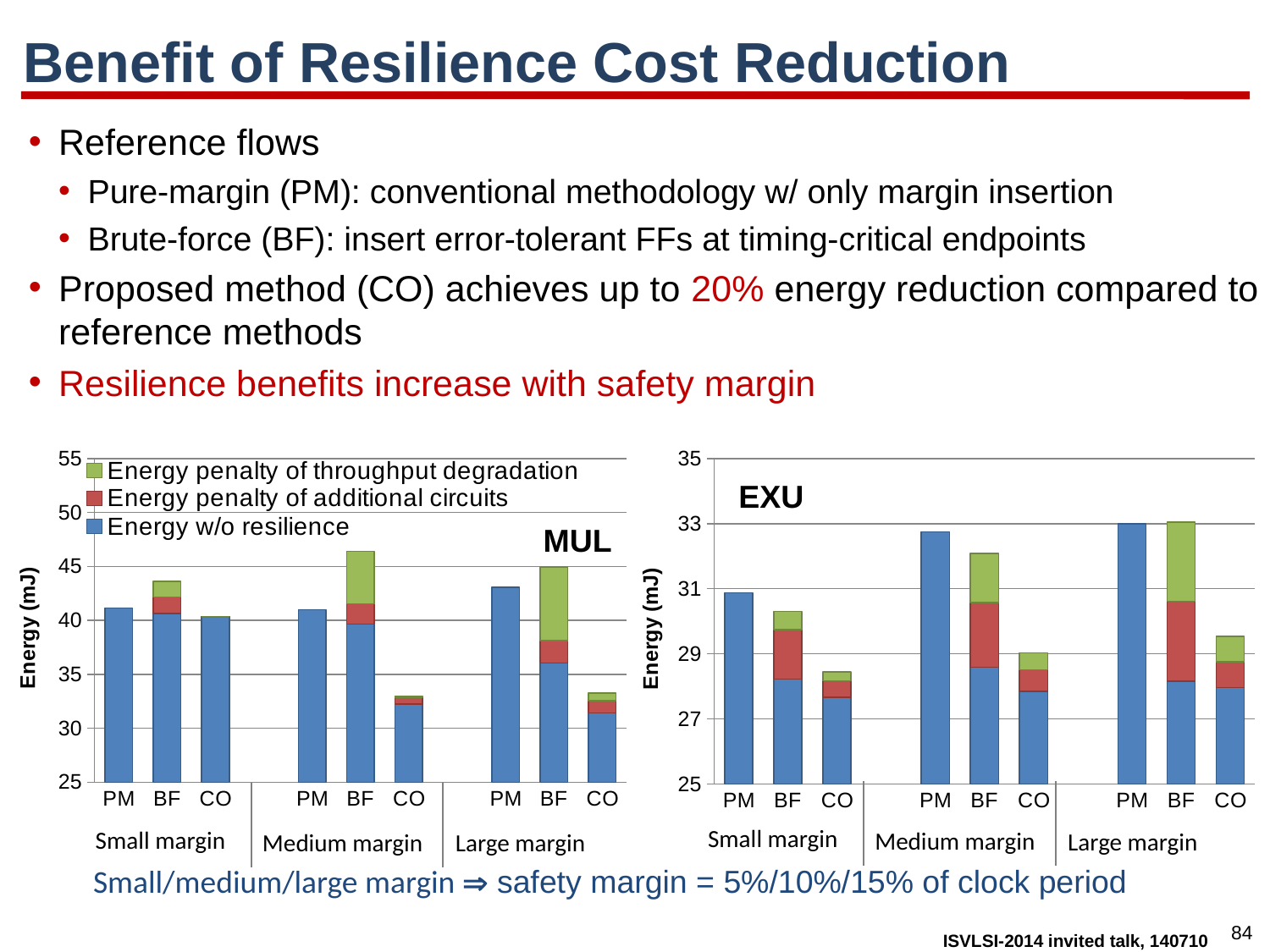
In the EXU chart, do the PM values rise or fall from Small margin to Large margin? rise How many series does the legend on the MUL chart list? 3 What kind of chart is the MUL chart? bar chart In the MUL chart, is the total for CO under Medium margin greater or less than 35? less In the EXU chart, is the value for PM under Medium margin greater or less than 31? greater In the MUL chart, which has the taller total bar under Medium margin, PM or BF? BF How many bars are plotted in the MUL chart? 9 In the MUL chart, which bar has the highest total energy? BF under Medium margin In the MUL chart, is the value for PM under Small margin greater or less than 40? greater In the EXU chart, which has the taller bar under Large margin, PM or CO? PM In the MUL chart legend, which series is shown in green? Energy penalty of throughput degradation